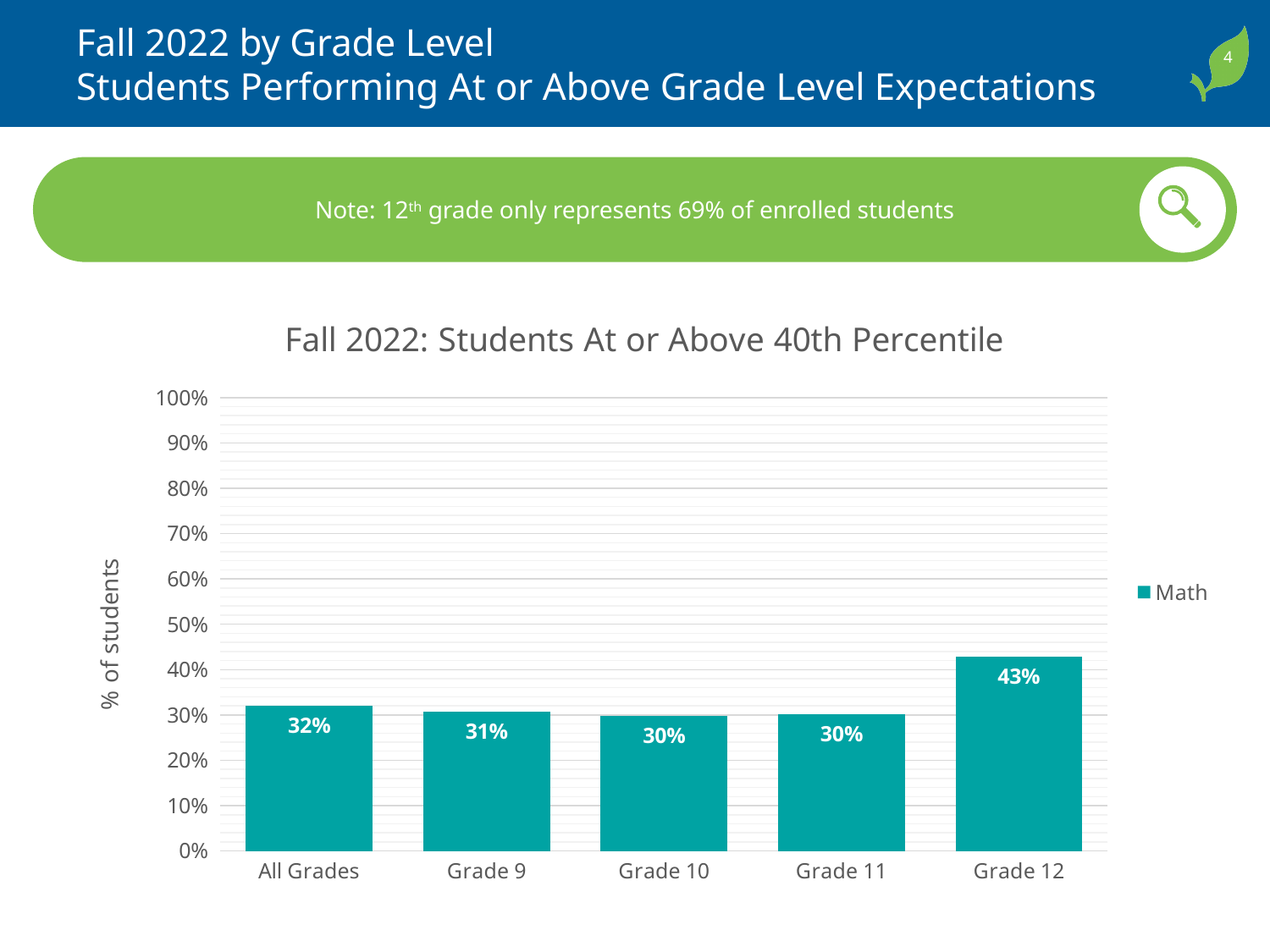
Which is larger, the value for Grade 12 or the value for Grade 11? Grade 12 What is the value for Grade 11? 30% What is the value for Grade 12? 43% Which category has the highest value? Grade 12 What kind of chart is shown on the slide? bar chart Is the value for Grade 12 greater or less than 40%? greater How many categories are shown on the x axis? 5 What is the difference between the values for All Grades and Grade 9? 1% How many series does the legend list? 1 What is the value for All Grades? 32% What is the difference between the values for Grade 12 and Grade 10? 13% What is the value for Grade 9? 31%